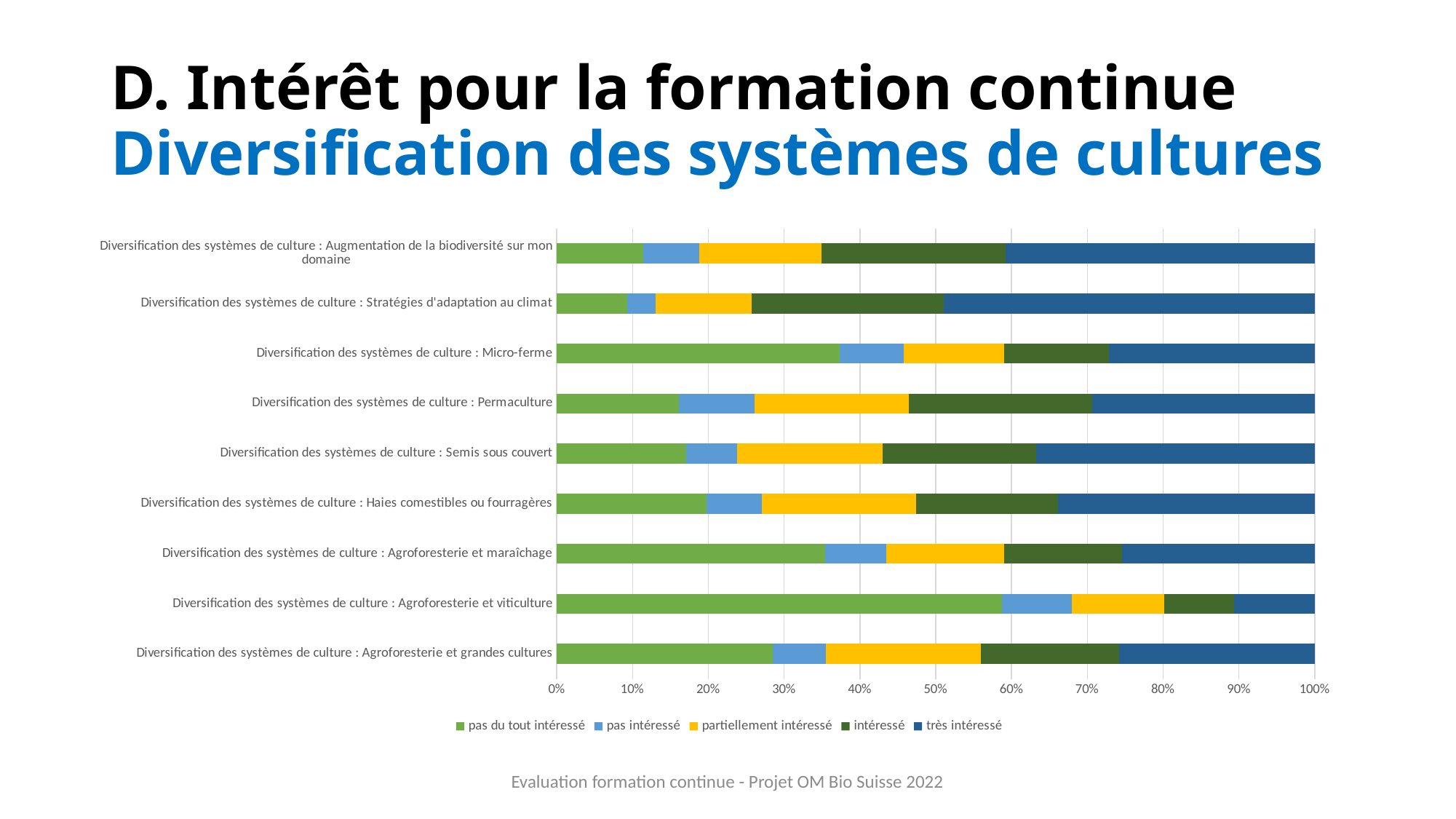
Which category has the largest 'pas du tout intéressé' share? Diversification des systèmes de culture : Agroforesterie et viticulture How many series does the legend list? 5 Which category has the smallest 'très intéressé' share? Diversification des systèmes de culture : Agroforesterie et viticulture Is the 'pas du tout intéressé' share for Micro-ferme greater or less than 30%? greater Which category has the largest 'très intéressé' share? Diversification des systèmes de culture : Stratégies d'adaptation au climat Which has the larger 'pas du tout intéressé' share: Micro-ferme or Permaculture? Micro-ferme Is the 'pas du tout intéressé' share for Agroforesterie et viticulture greater or less than 50%? greater What does each stacked bar total on the x axis? 100% Is the 'pas du tout intéressé' share for Augmentation de la biodiversité sur mon domaine greater or less than 20%? less How many categories (bars) does the chart show? 9 Which legend entry is shown in yellow? partiellement intéressé What kind of chart is shown on the slide? Stacked bar chart